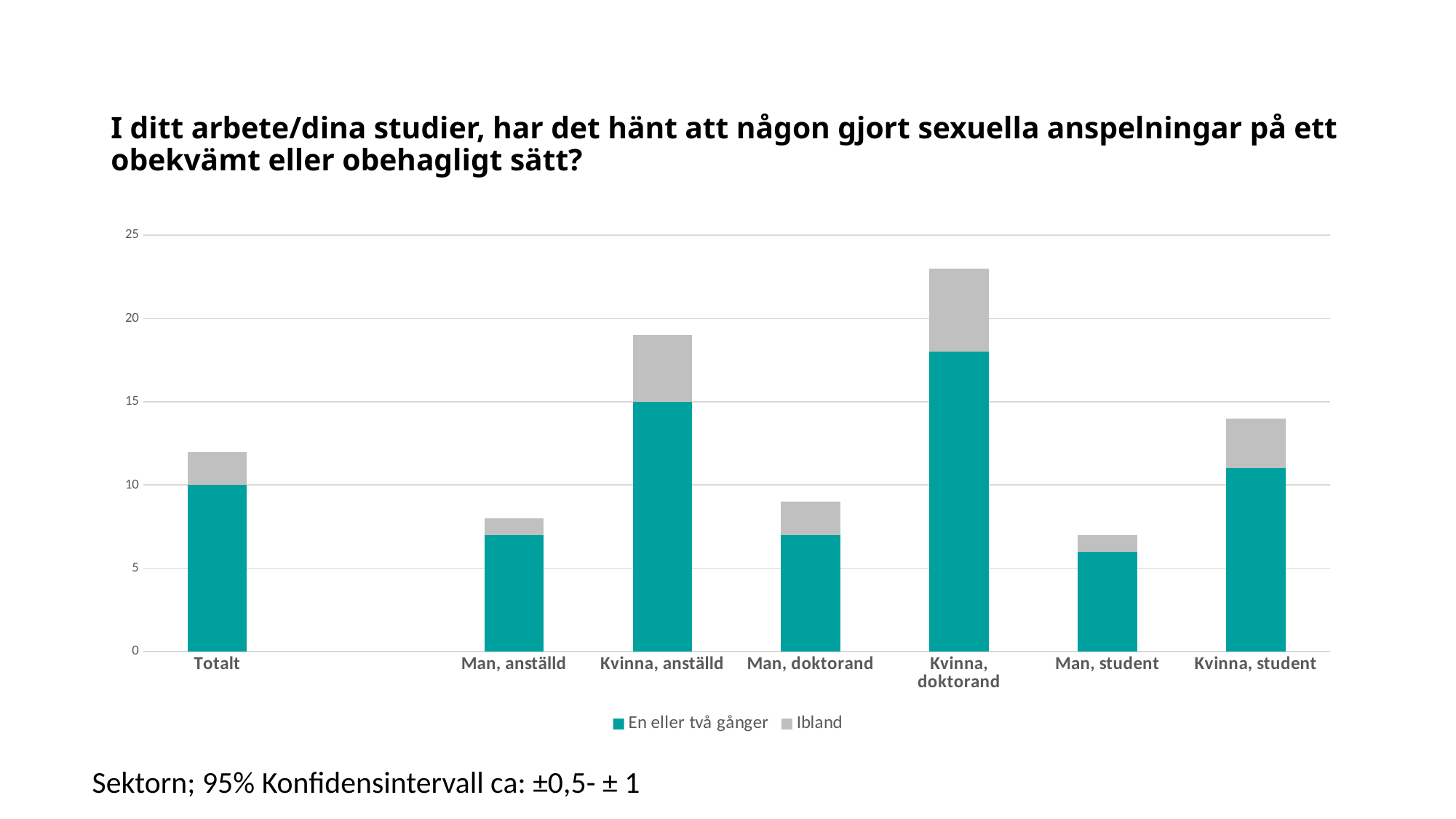
What kind of chart is shown on the slide? stacked bar chart What is the value of 'En eller två gånger' for Kvinna, anställd? 15 How many series does the legend list? 2 Which category has the tallest stacked bar? Kvinna, doktorand How many categories are shown on the x axis? 7 What is the value of 'En eller två gånger' for Totalt? 10 Which category has the shortest stacked bar? Man, student Is the total stacked value for Kvinna, doktorand greater or less than 20? greater Is the total stacked value for Man, anställd greater or less than 10? less Is the total stacked value for Kvinna, student greater or less than 10? greater Which has the larger total stacked bar, Kvinna, anställd or Man, doktorand? Kvinna, anställd Which colour represents the 'Ibland' series? grey